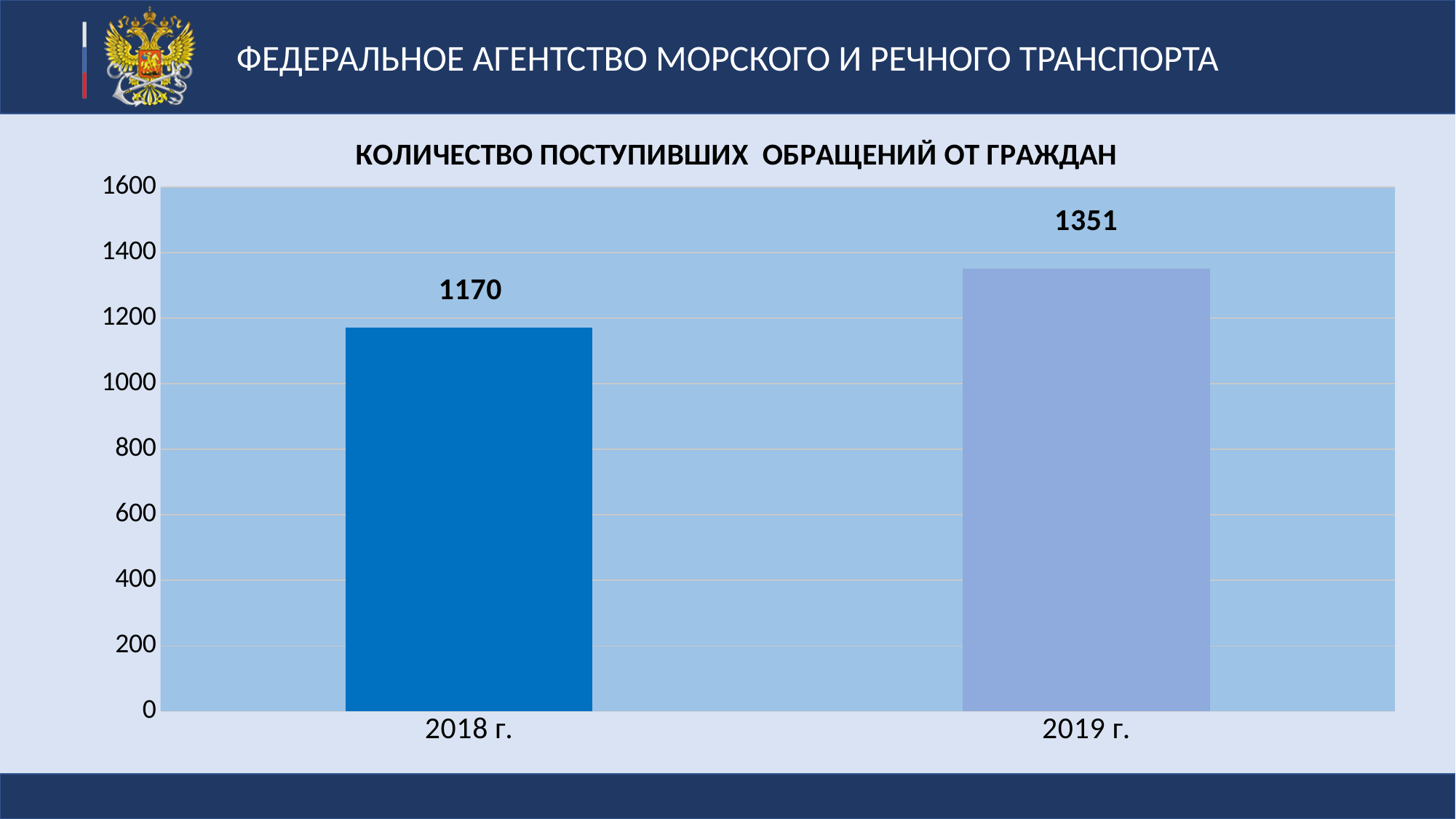
What is the value for 2019 г.? 1351 Do the values rise or fall from 2018 г. to 2019 г.? rise What is the difference between the values for 2019 г. and 2018 г.? 181 What is the title of the chart? КОЛИЧЕСТВО ПОСТУПИВШИХ ОБРАЩЕНИЙ ОТ ГРАЖДАН What kind of chart is shown on the slide? bar chart Which year has the highest value? 2019 г. Which is larger, the value for 2018 г. or the value for 2019 г.? 2019 г. Is the value for 2018 г. greater or less than 1200? less Which year has the lowest value? 2018 г. How many categories are shown on the x axis? 2 Is the value for 2019 г. greater or less than 1400? less What is the value for 2018 г.? 1170